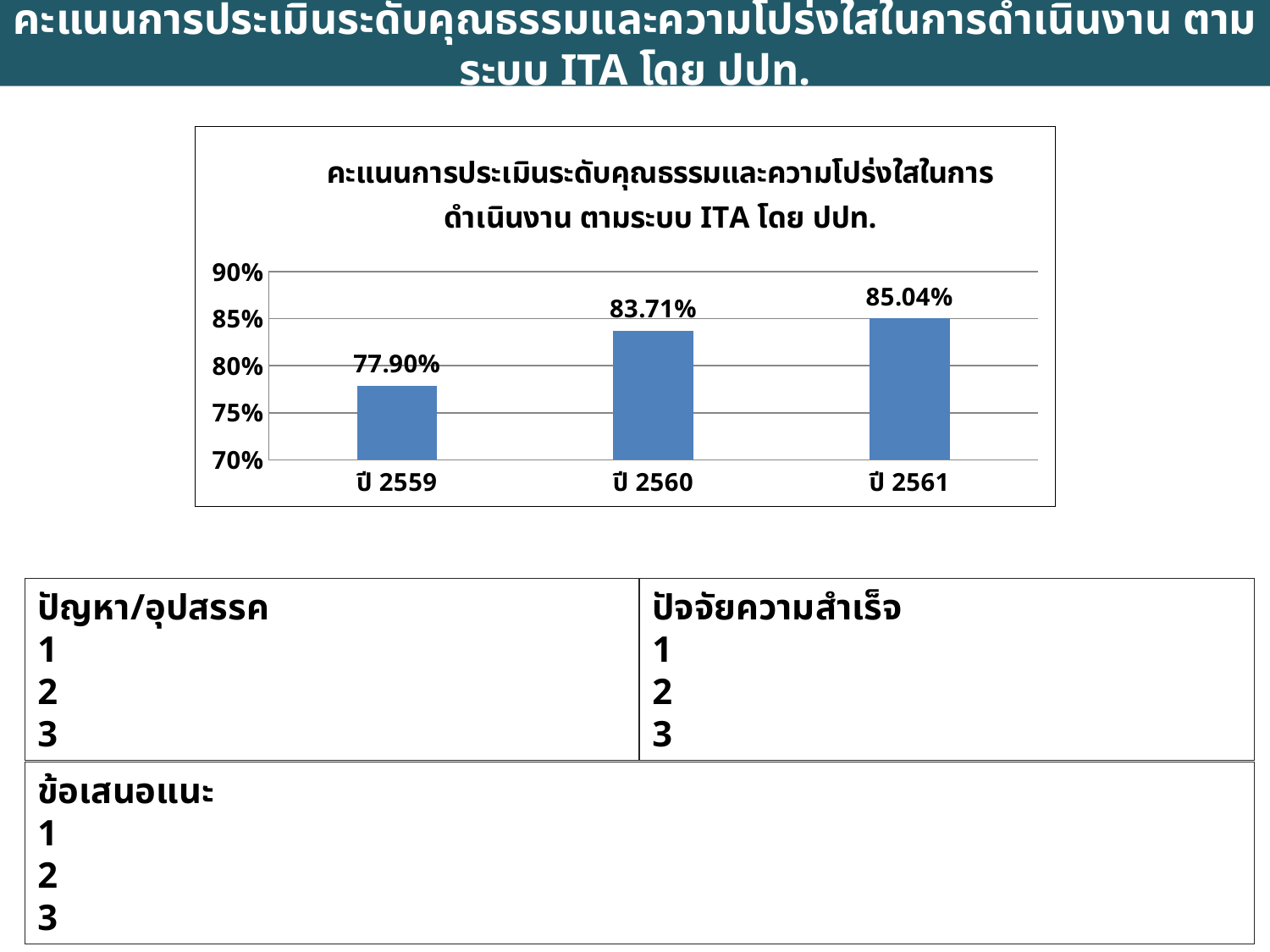
How many years are shown on the chart? 3 What is the value for ปี 2560? 83.71% Which year has the lowest score? ปี 2559 What is the difference between the values for ปี 2560 and ปี 2559? 5.81% What is the difference between the values for ปี 2561 and ปี 2559? 7.14% What is the value for ปี 2559? 77.90% What kind of chart is shown on the slide? bar chart Is the value for ปี 2559 greater or less than 80%? less Which year has the highest score? ปี 2561 Do the values rise or fall from ปี 2559 to ปี 2561? rise What is the value for ปี 2561? 85.04% Which is larger, the value for ปี 2560 or ปี 2561? ปี 2561